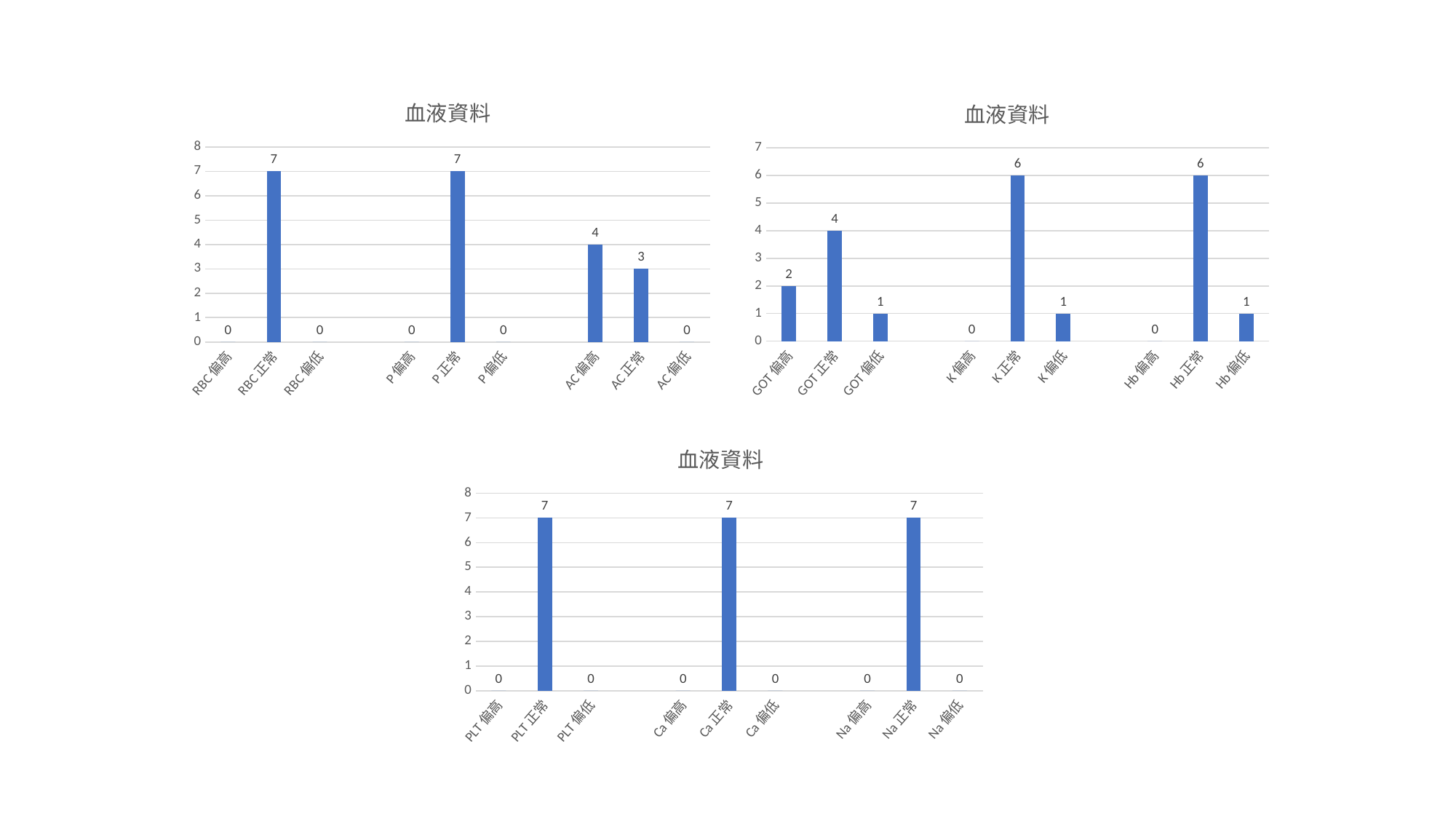
In the top-left chart, what is the value for AC 正常? 3 What kind of chart is the top-right chart? Bar chart In the top-left chart, which is larger, AC 偏高 or AC 正常? AC 偏高 In the bottom chart, what is the value for Na 正常? 7 What is the title of the bottom chart? 血液資料 In the top-right chart, which category has the lowest value? K 偏高 and Hb 偏高 (both 0) In the top-right chart, what is the value for K 正常? 6 In the top-left chart, what is the value for AC 偏高? 4 In the top-right chart, what is the difference between GOT 正常 and GOT 偏低? 3 How many categories are shown on the x axis of the bottom chart? 9 In the top-right chart, what is the value for GOT 偏高? 2 In the top-right chart, what is the difference between Hb 正常 and Hb 偏低? 5